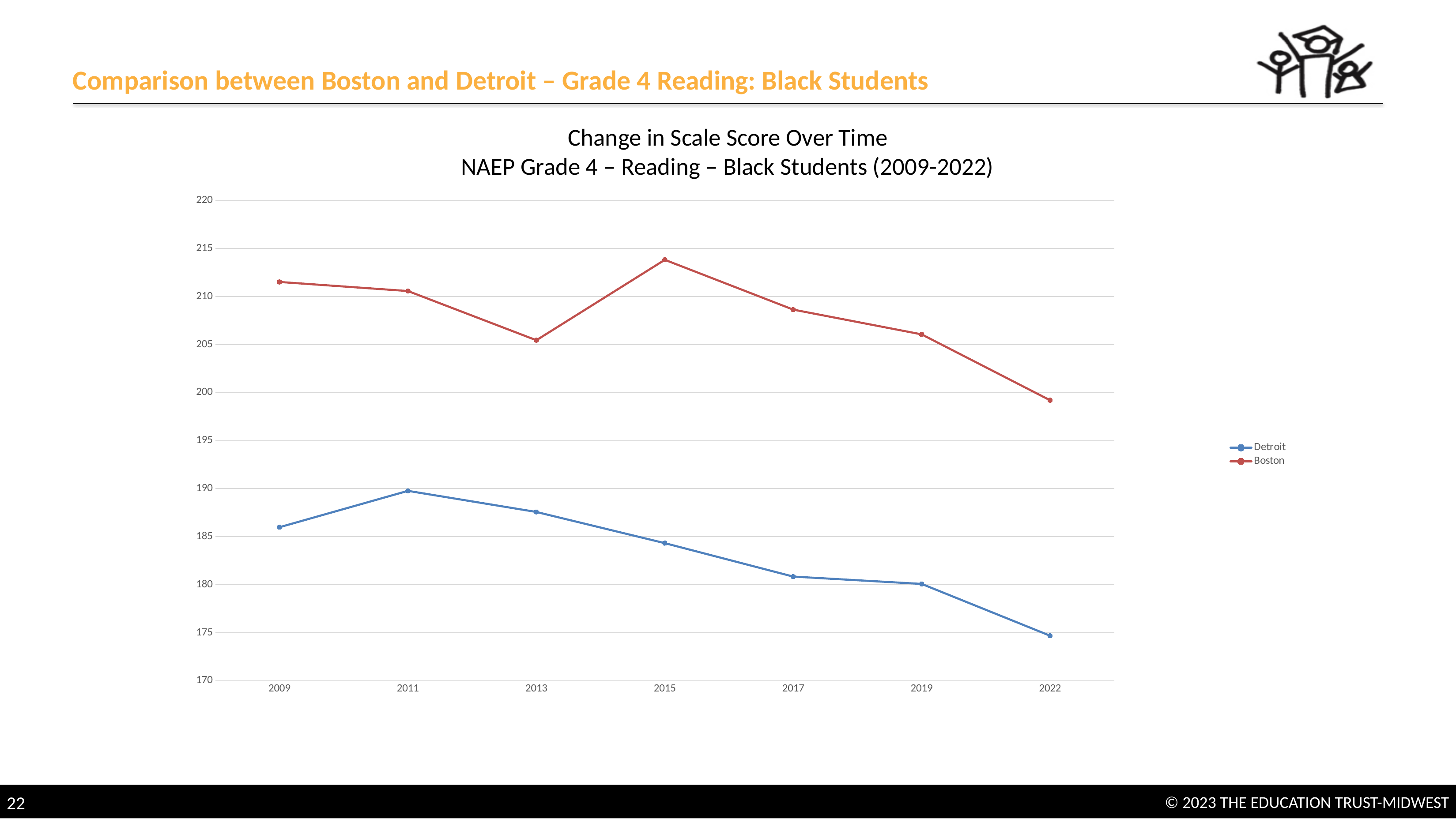
In which year does the Boston line reach its lowest value? 2022 Which series has the higher value in 2022, Detroit or Boston? Boston Which colour is used for the Boston line? red What kind of chart is shown on the slide? line chart Is the value for Boston in 2009 greater or less than 210? greater Does the Detroit line rise or fall from 2011 to 2022? fall Is the value for Detroit in 2022 greater or less than 180? less In which year does the Detroit line reach its highest value? 2011 How many series does the legend list? 2 How many years are plotted along the x axis? 7 In which year does the Detroit line reach its lowest value? 2022 In which year does the Boston line reach its highest value? 2015